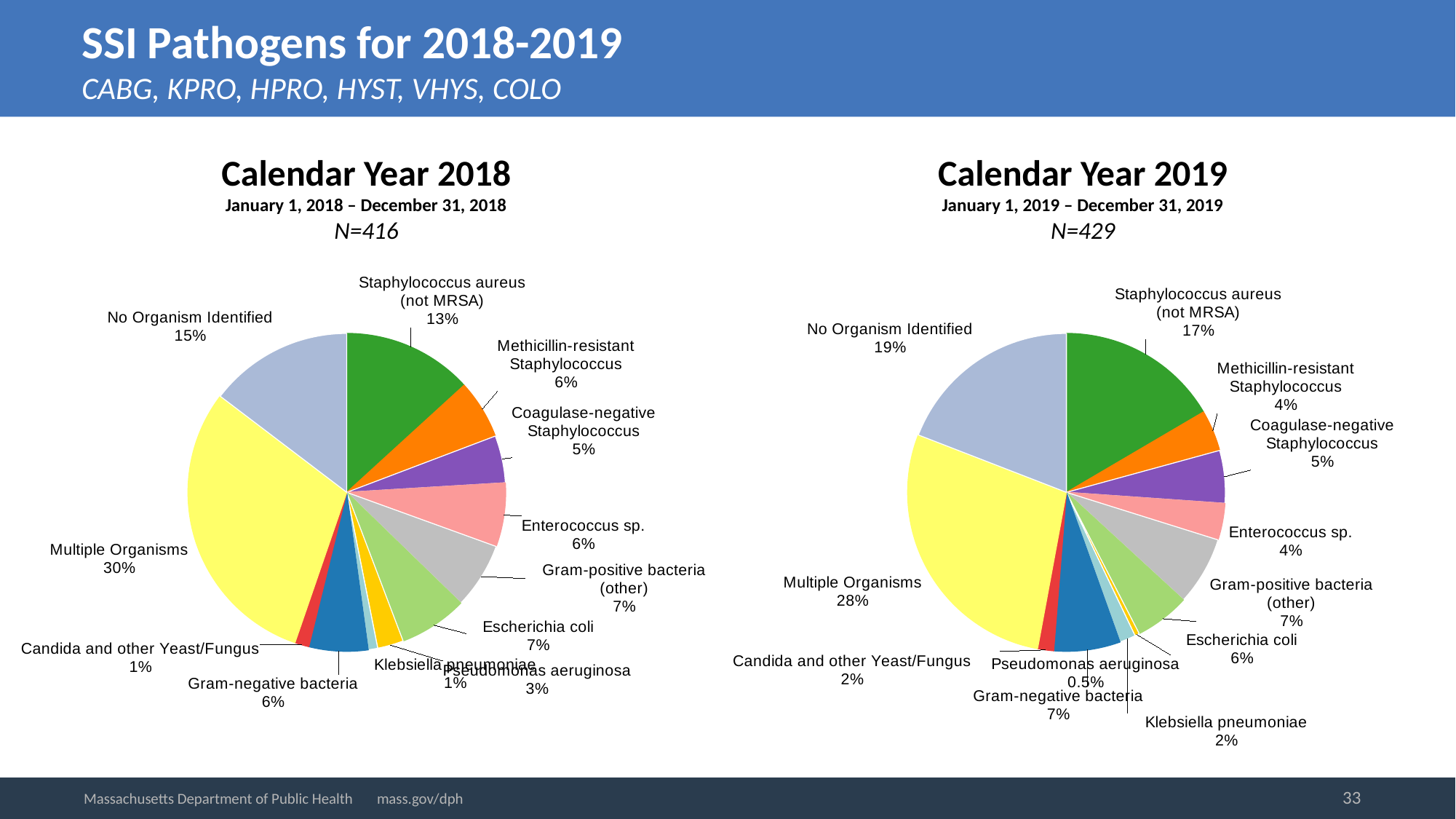
In the Calendar Year 2019 chart, what percentage is labelled for Pseudomonas aeruginosa? 0.5% In the Calendar Year 2018 chart, what percentage is labelled for Gram-negative bacteria? 6% In the Calendar Year 2019 chart, what percentage is labelled for No Organism Identified? 19% What is the difference between the Staphylococcus aureus (not MRSA) percentage in the Calendar Year 2019 chart and in the Calendar Year 2018 chart? 4% In the Calendar Year 2018 chart, what percentage is labelled for Multiple Organisms? 30% How many slices does the Calendar Year 2019 pie chart have? 12 In the Calendar Year 2018 chart, which category has the largest slice? Multiple Organisms What type of chart is used for Calendar Year 2018? Pie chart Which is larger: Methicillin-resistant Staphylococcus in the Calendar Year 2018 chart or in the Calendar Year 2019 chart? Calendar Year 2018 In the Calendar Year 2018 chart, what percentage is labelled for Staphylococcus aureus (not MRSA)? 13% What is the N value shown for the Calendar Year 2019 chart? N=429 In the Calendar Year 2019 chart, which category has the smallest slice? Pseudomonas aeruginosa